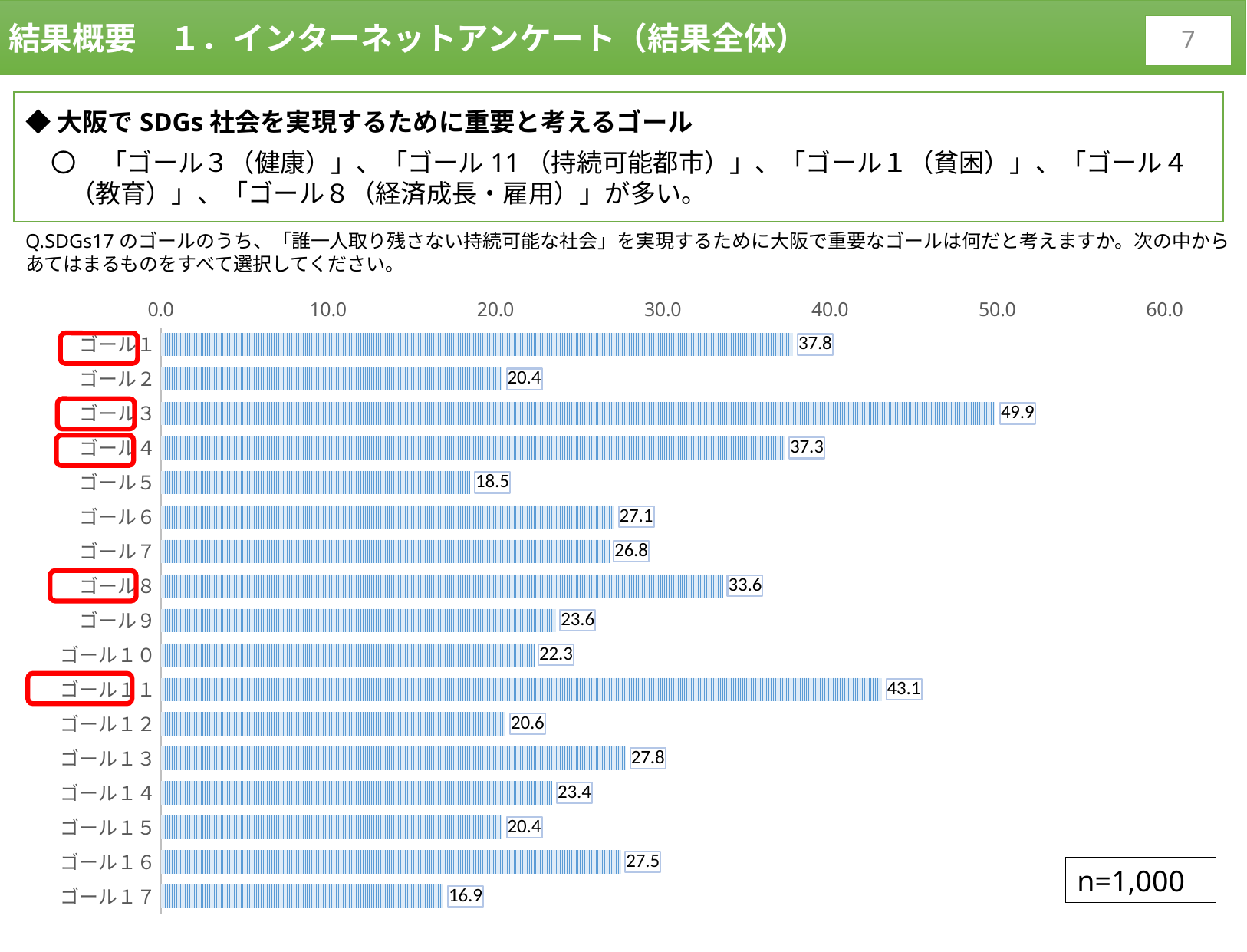
What kind of chart is shown on the slide? bar chart What is the difference between the values for ゴール1 and ゴール4? 0.5 Which goal has the highest value? ゴール3 What sample size (n) is shown next to the chart? n=1,000 Which is larger, the value for ゴール8 or the value for ゴール13? ゴール8 What is the value for ゴール17? 16.9 What is the difference between the values for ゴール3 and ゴール11? 6.8 What is the value for ゴール3? 49.9 Which goal has the lowest value? ゴール17 What is the value for ゴール11? 43.1 How many goals (categories) are shown in the chart? 17 Is the value for ゴール11 greater or less than 40.0? greater